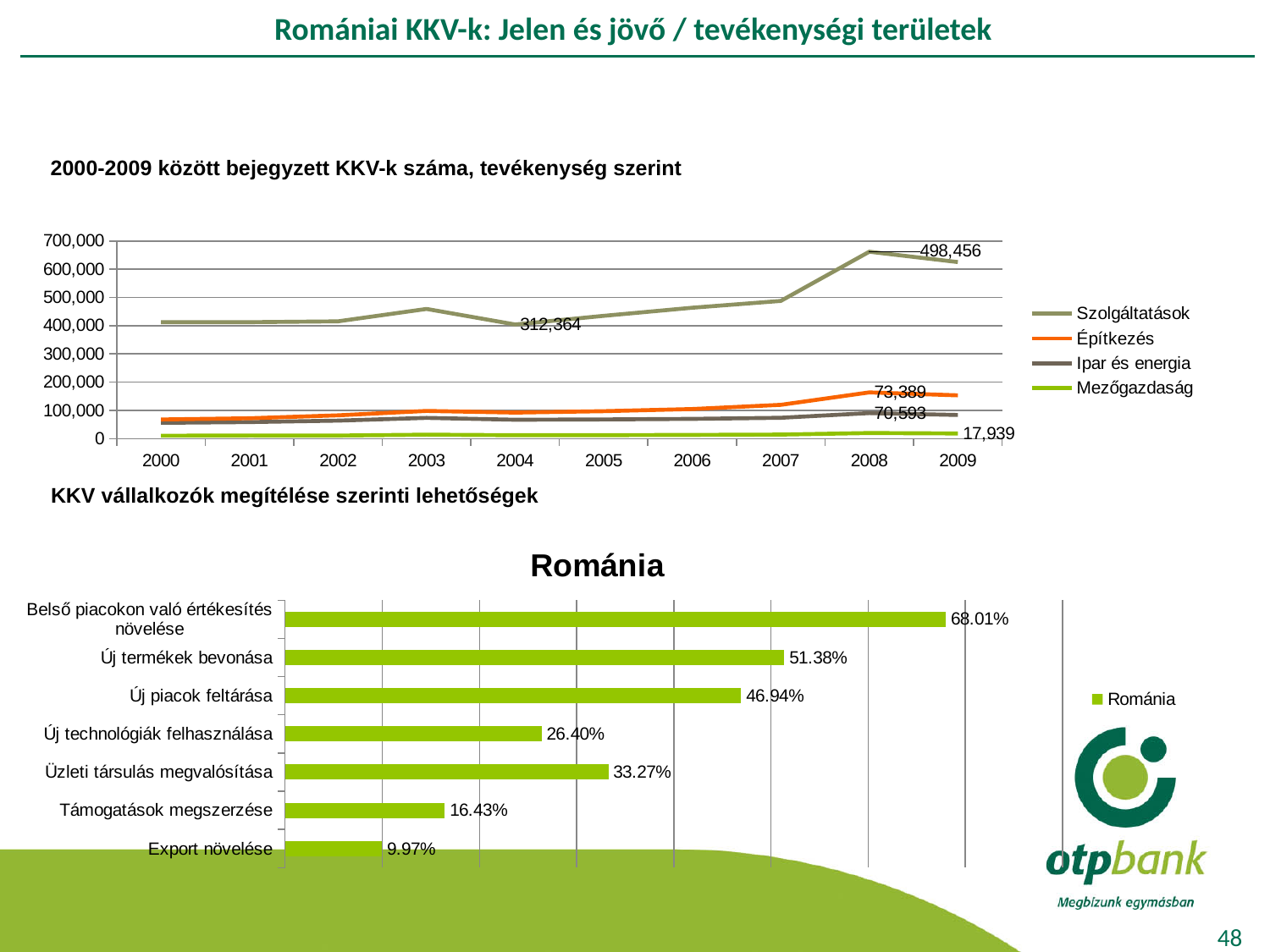
In the bottom bar chart titled 'Románia', which is larger: 'Üzleti társulás megvalósítása' or 'Új technológiák felhasználása'? Üzleti társulás megvalósítása In the bottom bar chart titled 'Románia', what is the value for 'Belső piacokon való értékesítés növelése'? 68.01% How many categories are shown in the bottom bar chart titled 'Románia'? 7 In the bottom bar chart titled 'Románia', which category has the lowest value? Export növelése In the bottom bar chart titled 'Románia', what is the value for 'Export növelése'? 9.97% What kind of chart is the bottom chart titled 'Románia'? Bar chart In the bottom bar chart titled 'Románia', what is the value for 'Új termékek bevonása'? 51.38% In the bottom bar chart titled 'Románia', what is the difference between 'Új piacok feltárása' and 'Új technológiák felhasználása'? 20.54% How many series does the legend of the top line chart list? 4 In the bottom bar chart titled 'Románia', which category has the highest value? Belső piacokon való értékesítés növelése What kind of chart is the top chart showing the number of registered SMEs between 2000 and 2009? Line chart